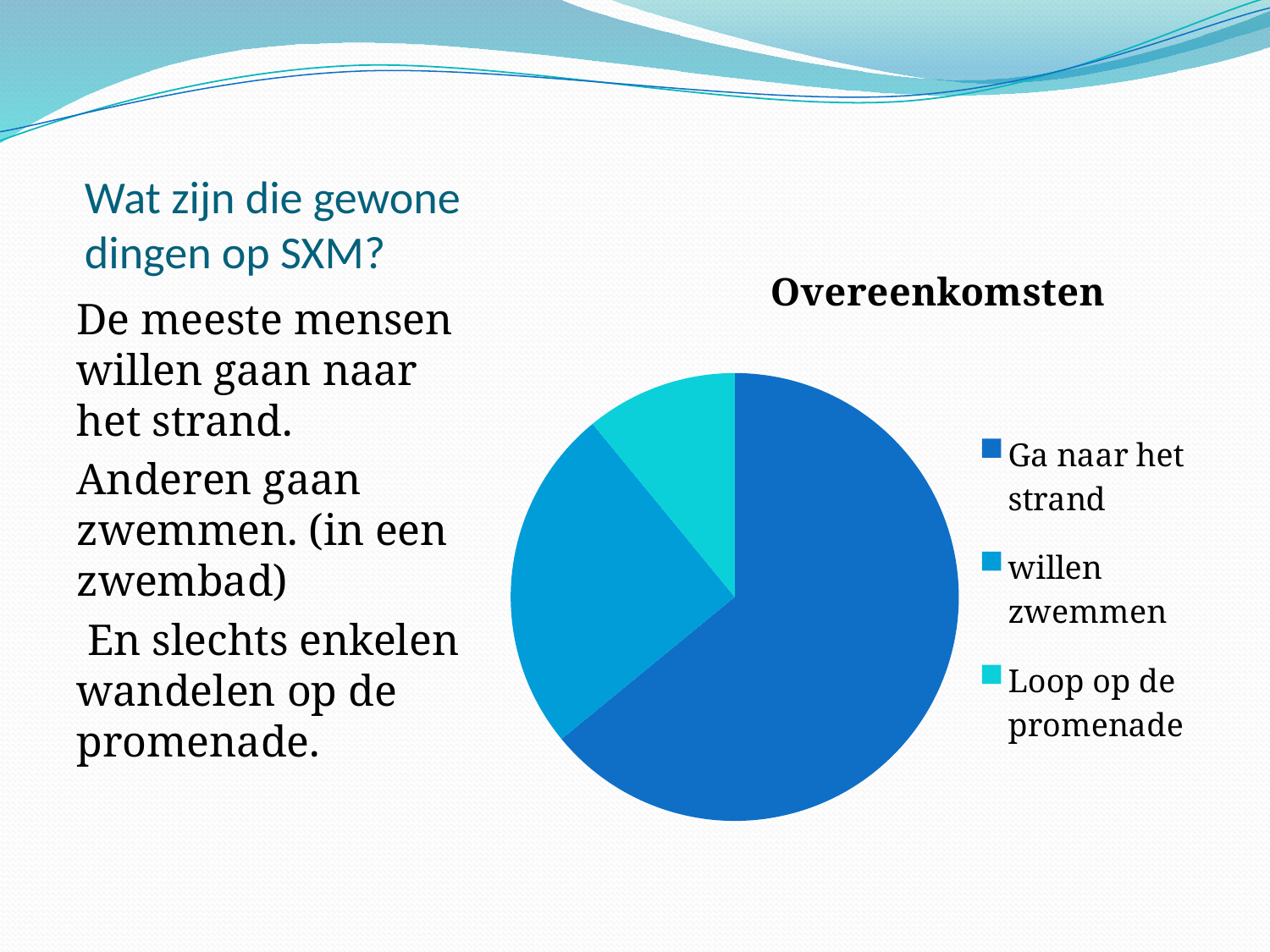
Does the 'Ga naar het strand' slice take up more or less than half of the pie? more Which slice is larger: 'Ga naar het strand' or 'willen zwemmen'? Ga naar het strand Which slice is larger: 'willen zwemmen' or 'Loop op de promenade'? willen zwemmen Which category has the smallest slice of the pie? Loop op de promenade What kind of chart is shown on the slide? pie chart What is the title of the chart? Overeenkomsten Which category has the largest slice of the pie? Ga naar het strand How many entries does the chart's legend list? 3 Which legend entry is shown in the lightest (turquoise) colour? Loop op de promenade How many slices does the pie chart have? 3